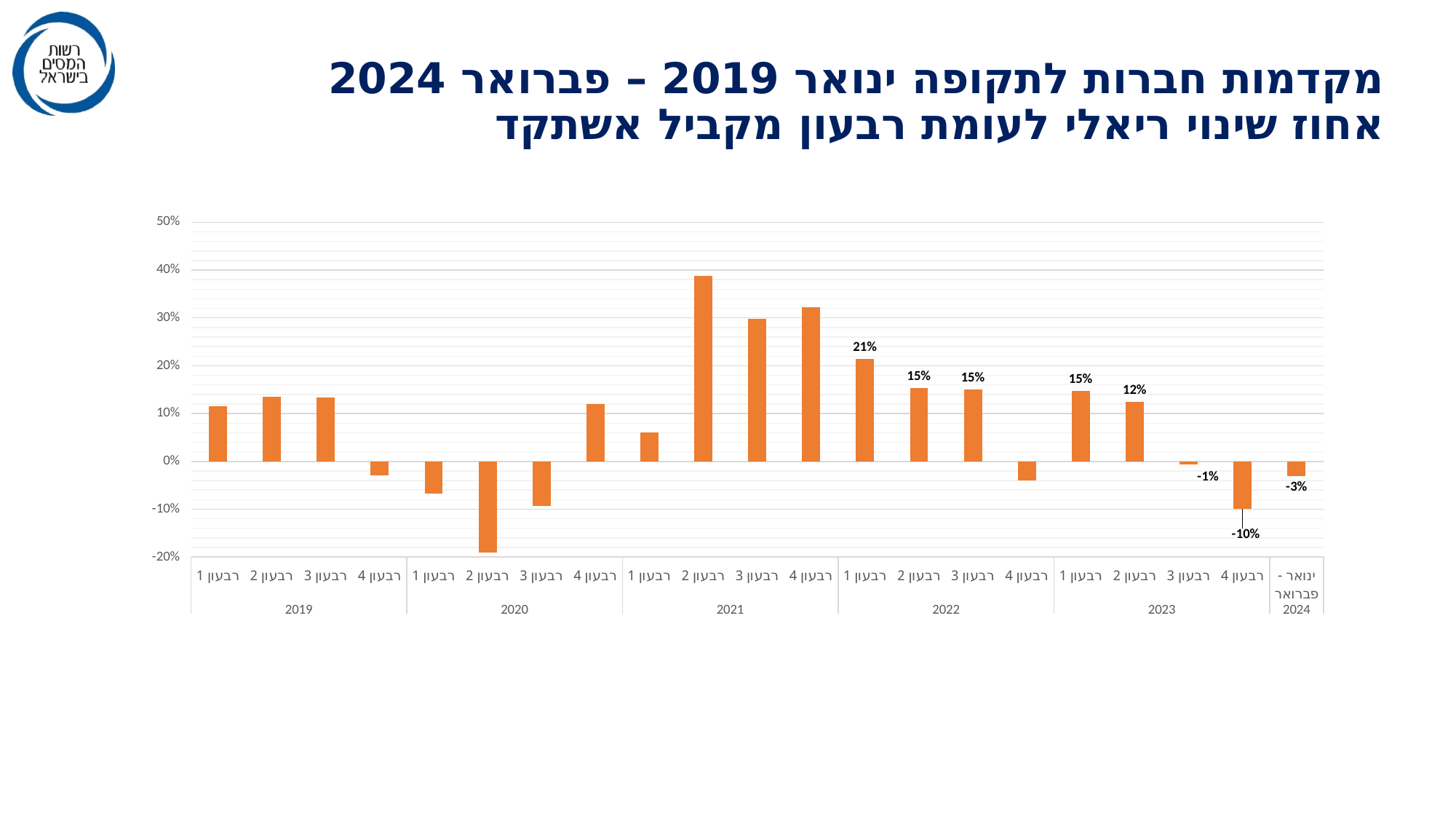
Which quarter has the highest value in the chart? רבעון 2 of 2021 What is the value for ינואר - פברואר 2024? -3% How many bars are plotted in the chart? 21 What is the value for רבעון 2 of 2023? 12% Is the value for רבעון 2 of 2021 greater or less than 30%? greater What is the value for רבעון 4 of 2023? -10% What is the value for רבעון 1 of 2022? 21% What kind of chart is shown on the slide? bar chart Which quarter has the lowest value in the chart? רבעון 2 of 2020 What is the difference between the value for רבעון 1 of 2022 and the value for רבעון 2 of 2022? 6% What is the difference between the value for רבעון 2 of 2023 and the value for רבעון 4 of 2023? 22% Which is larger, the value for רבעון 1 of 2023 or the value for רבעון 2 of 2023? רבעון 1 of 2023